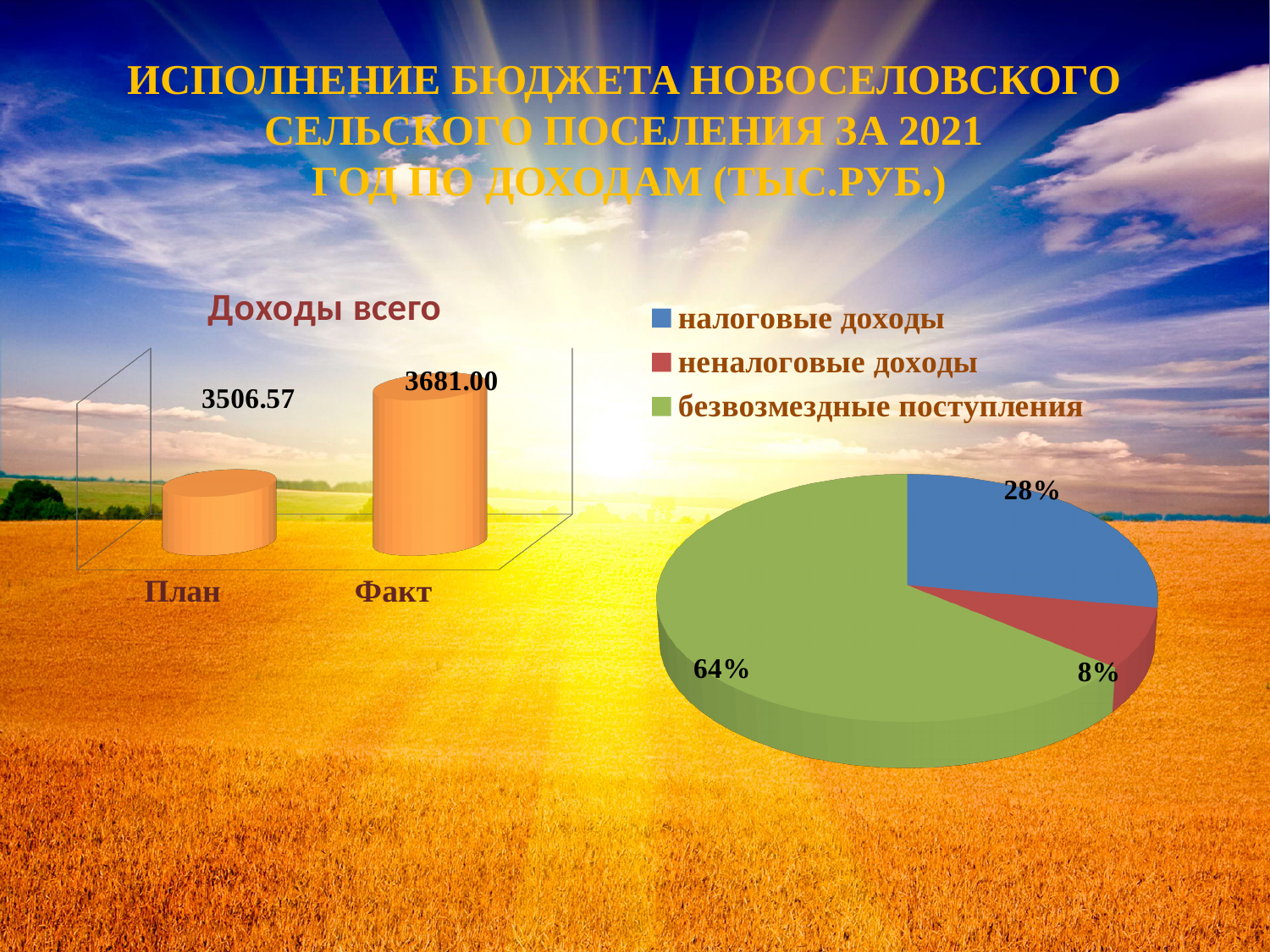
In the 'Доходы всего' chart, what is the value for План? 3506.57 In the pie chart on the right, which category has the largest share? безвозмездные поступления What kind of chart is the 'Доходы всего' chart on the left? Bar chart In the pie chart on the right, what share is налоговые доходы? 28% In the pie chart on the right, how many entries does the legend list? 3 In the 'Доходы всего' chart, what is the difference between Факт and План? 174.43 In the 'Доходы всего' chart, what is the value for Факт? 3681.00 In the pie chart on the right, what share is неналоговые доходы? 8% In the 'Доходы всего' chart, which category has the higher value, План or Факт? Факт In the pie chart on the right, what share is безвозмездные поступления? 64% In the 'Доходы всего' chart, how many categories are shown? 2 In the pie chart on the right, which category has the smallest share? неналоговые доходы